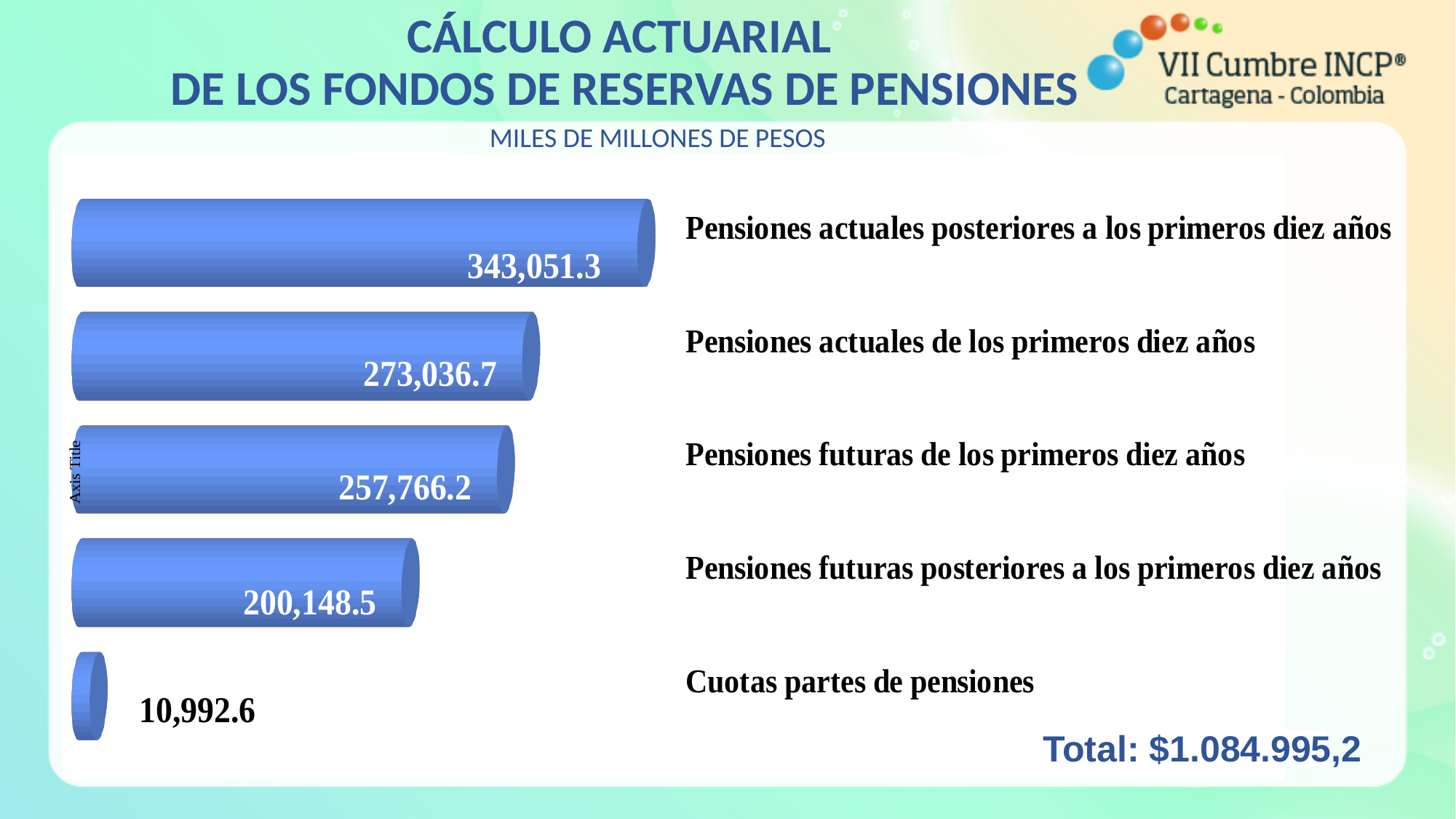
Which category has the lowest value? Cuotas partes de pensiones Which category has the highest value? Pensiones actuales posteriores a los primeros diez años What is the difference between Pensiones futuras posteriores a los primeros diez años and Cuotas partes de pensiones? 189,155.9 What is the value for Pensiones futuras de los primeros diez años? 257,766.2 What is the difference between Pensiones actuales posteriores a los primeros diez años and Pensiones actuales de los primeros diez años? 70,014.6 What is the value for Pensiones actuales posteriores a los primeros diez años? 343,051.3 What unit is stated above the chart? MILES DE MILLONES DE PESOS What is the value for Cuotas partes de pensiones? 10,992.6 Which is larger: Pensiones actuales de los primeros diez años or Pensiones futuras de los primeros diez años? Pensiones actuales de los primeros diez años What total is printed at the bottom right of the chart? $1.084.995,2 What kind of chart is shown on the slide? Bar chart How many categories are shown in the chart? 5